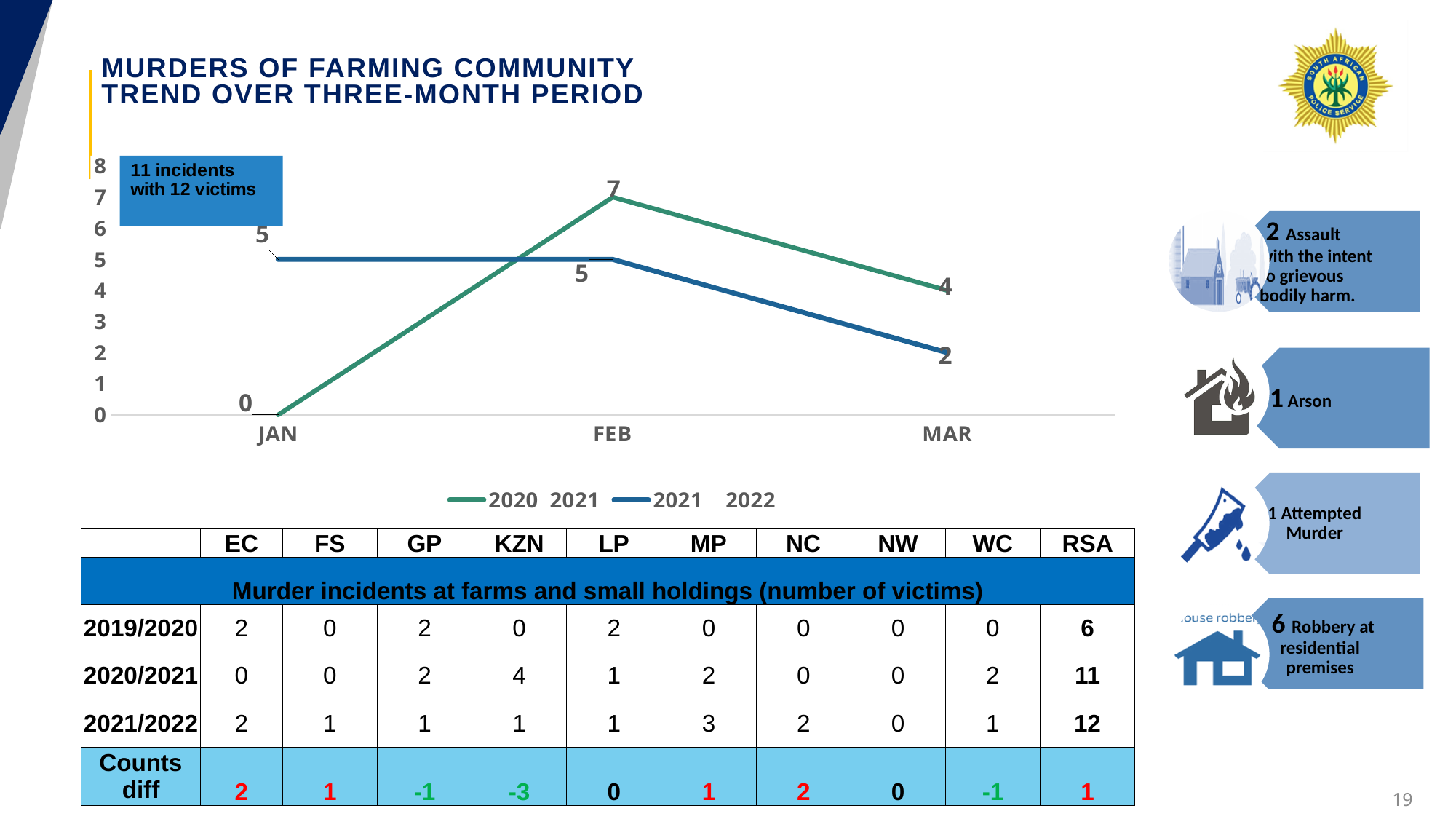
What is the value for the 2021 2022 series in JAN? 5 Which series has the larger value in JAN, 2020 2021 or 2021 2022? 2021 2022 What is the value for the 2020 2021 series in JAN? 0 In which month is the 2021 2022 series lowest? MAR How many series does the chart legend list? 2 What kind of chart is shown on the slide? line chart What is the value for the 2020 2021 series in FEB? 7 Does the 2021 2022 series rise or fall from FEB to MAR? fall In which month is the 2020 2021 series highest? FEB What is the value for the 2021 2022 series in MAR? 2 What is the difference between the 2020 2021 and 2021 2022 values in MAR? 2 How many months are plotted along the x axis of the chart? 3